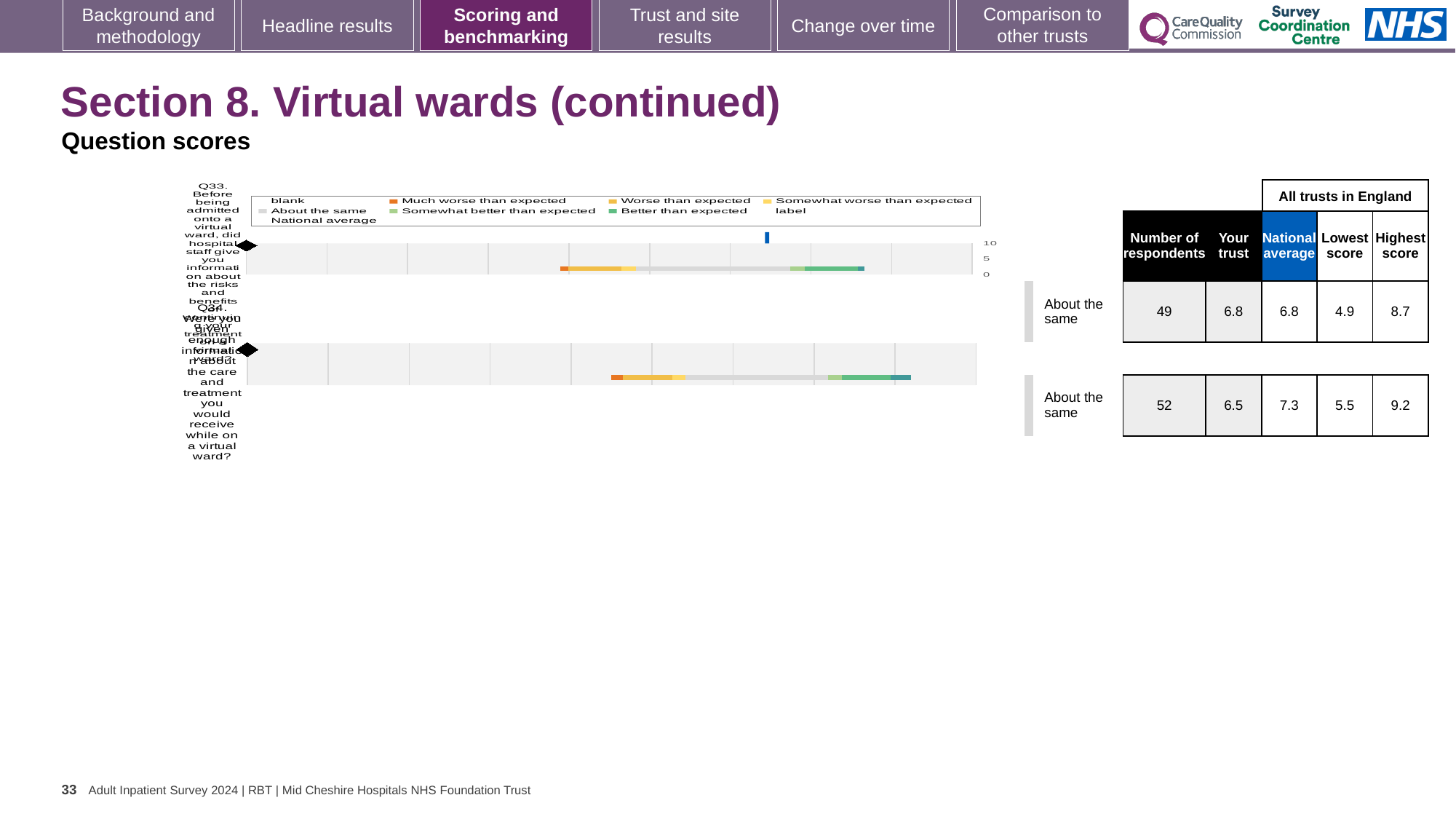
In the table next to the chart, what is the 'Your trust' score for Q33? 6.8 How many entries does the chart legend list? 9 How many questions (bars) are plotted in the chart? 2 In the table next to the chart, how many respondents answered Q34? 52 In the table next to the chart, what is the highest score across all trusts in England for Q34? 9.2 In the table next to the chart, what is the difference in number of respondents between Q34 and Q33? 3 In the table next to the chart, what is the 'Your trust' score for Q34? 6.5 What kind of chart is shown on the slide? bar chart What colour represents 'Much worse than expected' in the chart legend? orange In the table next to the chart, what is the difference between the national average and the 'Your trust' score for Q34? 0.8 In the table next to the chart, which question has the higher national average, Q33 or Q34? Q34 What colour represents 'Better than expected' in the chart legend? green